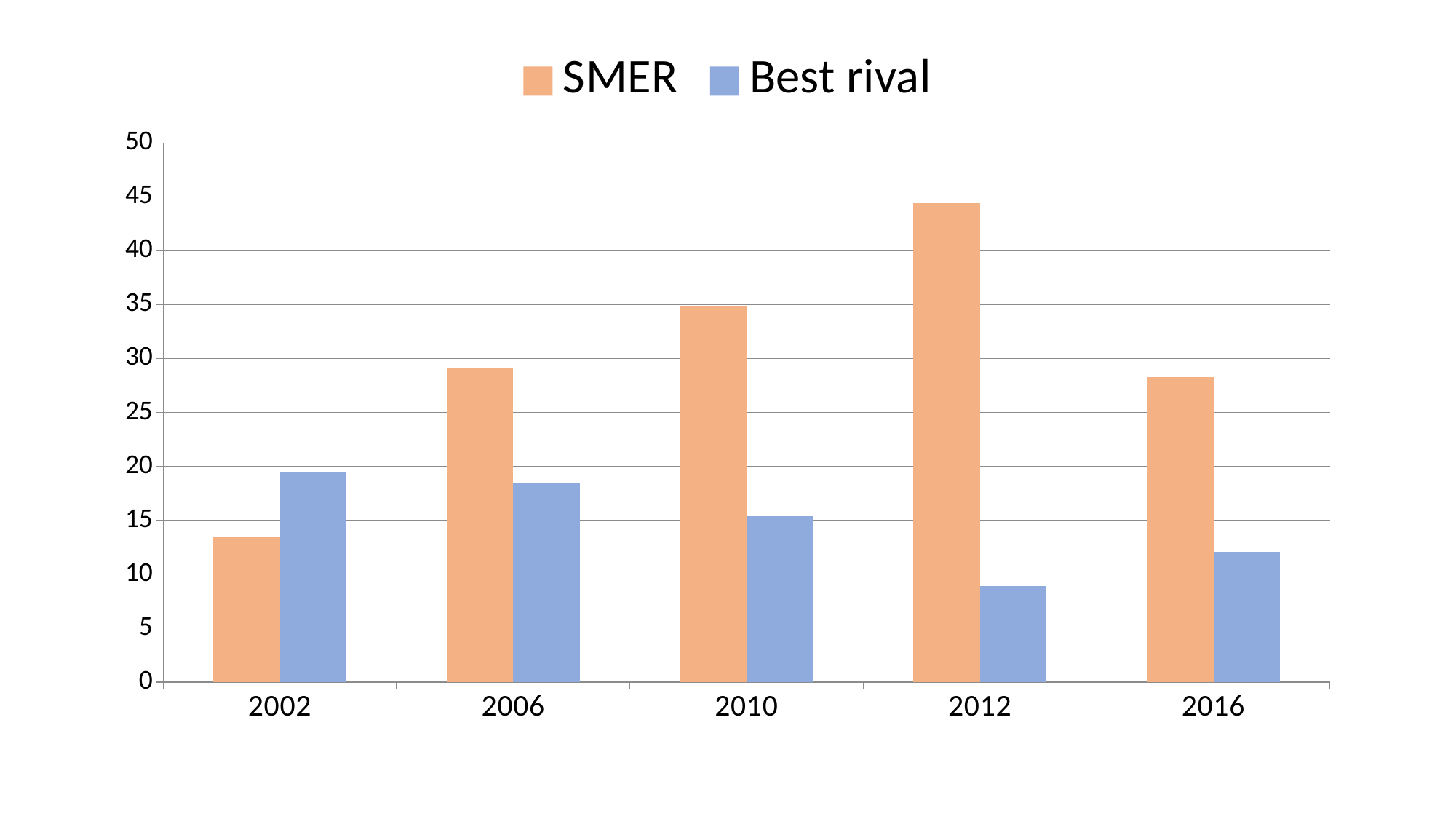
In 2002, which is larger: SMER or Best rival? Best rival In 2012, which is larger: SMER or Best rival? SMER Is the SMER value for 2012 greater or less than 40? greater How many series does the legend list? 2 What kind of chart is shown on the slide? bar chart How many years are shown on the x axis? 5 In which year is the SMER value highest? 2012 Is the SMER value for 2002 greater or less than 15? less In which year is the Best rival value lowest? 2012 Is the Best rival value for 2012 greater or less than 10? less Does the Best rival value rise or fall from 2002 to 2012? fall In which year is the SMER value lowest? 2002